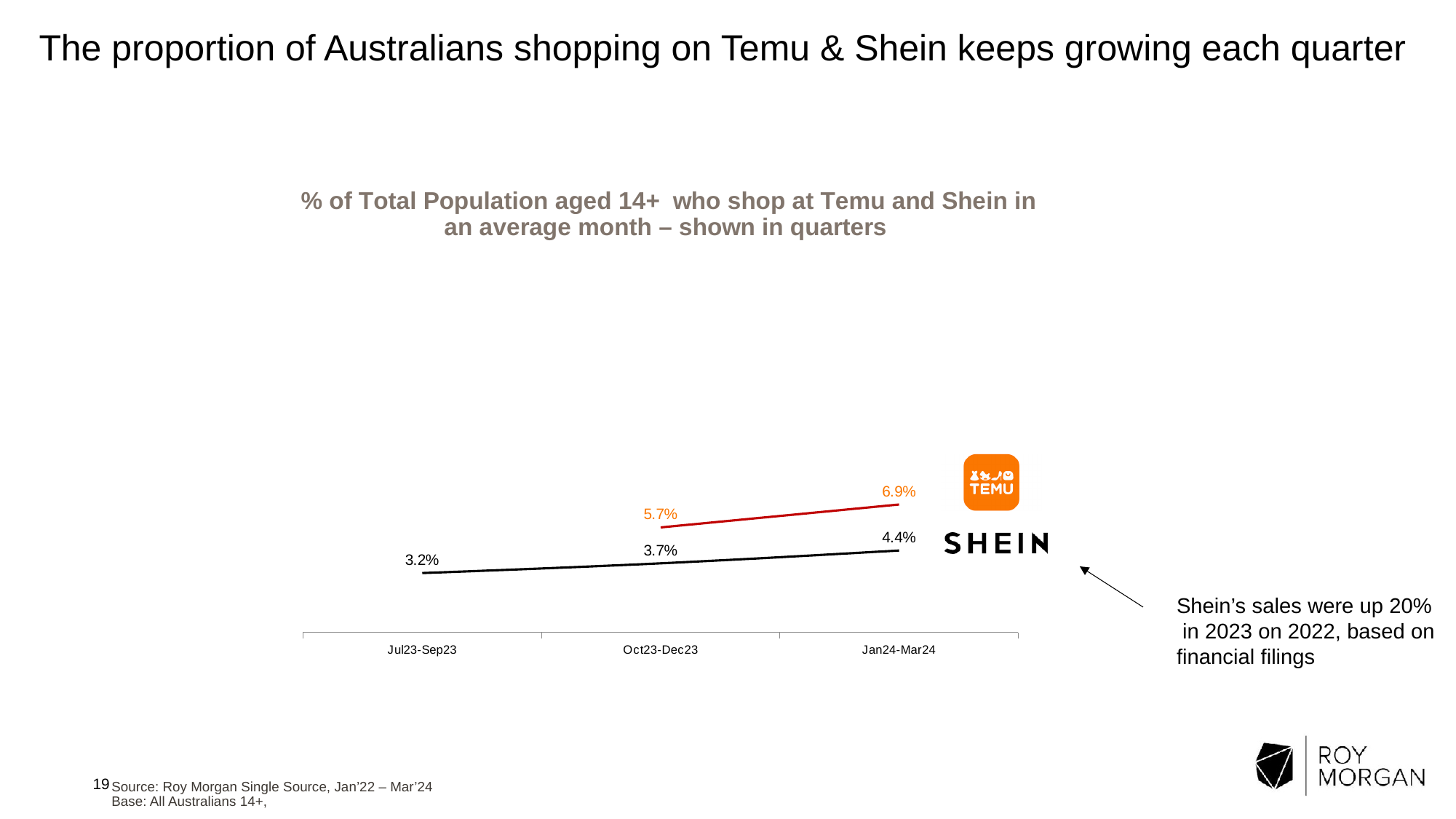
In which quarter is Shein's value lowest? Jul23-Sep23 In which quarter does Shein reach its highest value? Jan24-Mar24 What value is shown for Shein in the Jan24-Mar24 quarter? 4.4% Which had the higher value in Oct23-Dec23, Temu or Shein? Temu How many quarters are shown on the x axis? 3 By how many percentage points did Temu's value increase from Oct23-Dec23 to Jan24-Mar24? 1.2 percentage points What percentage of Australians aged 14+ shopped at Temu in an average month in Jan24-Mar24? 6.9% What is the difference between Temu's and Shein's values in Jan24-Mar24? 2.5 percentage points Do Shein's values rise or fall across the quarters shown? Rise What kind of chart is shown on the slide? Line chart What value is shown for Temu in the Oct23-Dec23 quarter? 5.7% What percentage of Australians aged 14+ shopped at Shein in an average month in Jul23-Sep23? 3.2%